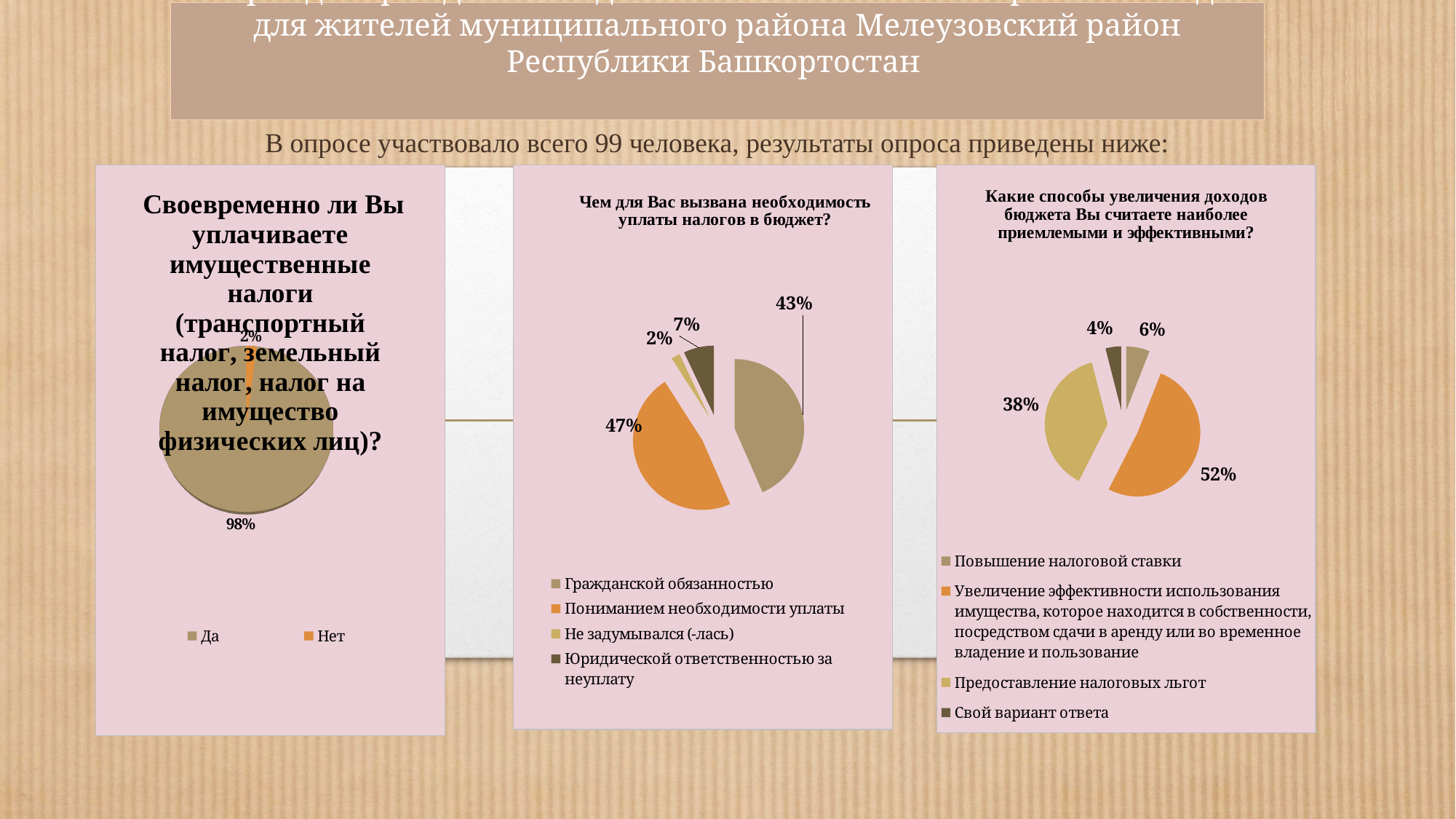
In the middle chart (Чем для Вас вызвана необходимость уплаты налогов в бюджет?), which answer has the smallest share? Не задумывался (-лась) In the left chart (Своевременно ли Вы уплачиваете имущественные налоги...), what share of respondents answered "Нет"? 2% What type of chart is used in the left chart (Своевременно ли Вы уплачиваете имущественные налоги...)? Pie chart In the right chart (Какие способы увеличения доходов бюджета...), which is larger: the share for "Повышение налоговой ставки" or for "Свой вариант ответа"? Повышение налоговой ставки How many categories does the legend of the middle chart (Чем для Вас вызвана необходимость уплаты налогов в бюджет?) list? 4 In the right chart (Какие способы увеличения доходов бюджета...), what share corresponds to "Предоставление налоговых льгот"? 38% In the right chart (Какие способы увеличения доходов бюджета...), which answer has the largest share? Увеличение эффективности использования имущества, которое находится в собственности, посредством сдачи в аренду или во временное владение и пользование In the middle chart (Чем для Вас вызвана необходимость уплаты налогов в бюджет?), what share corresponds to "Пониманием необходимости уплаты"? 47% In the middle chart (Чем для Вас вызвана необходимость уплаты налогов в бюджет?), what share corresponds to "Юридической ответственностью за неуплату"? 7% In the middle chart (Чем для Вас вызвана необходимость уплаты налогов в бюджет?), what is the difference between the shares for "Пониманием необходимости уплаты" and "Гражданской обязанностью"? 4% In the left chart (Своевременно ли Вы уплачиваете имущественные налоги...), what share of respondents answered "Да"? 98% In the middle chart (Чем для Вас вызвана необходимость уплаты налогов в бюджет?), which answer has the largest share? Пониманием необходимости уплаты